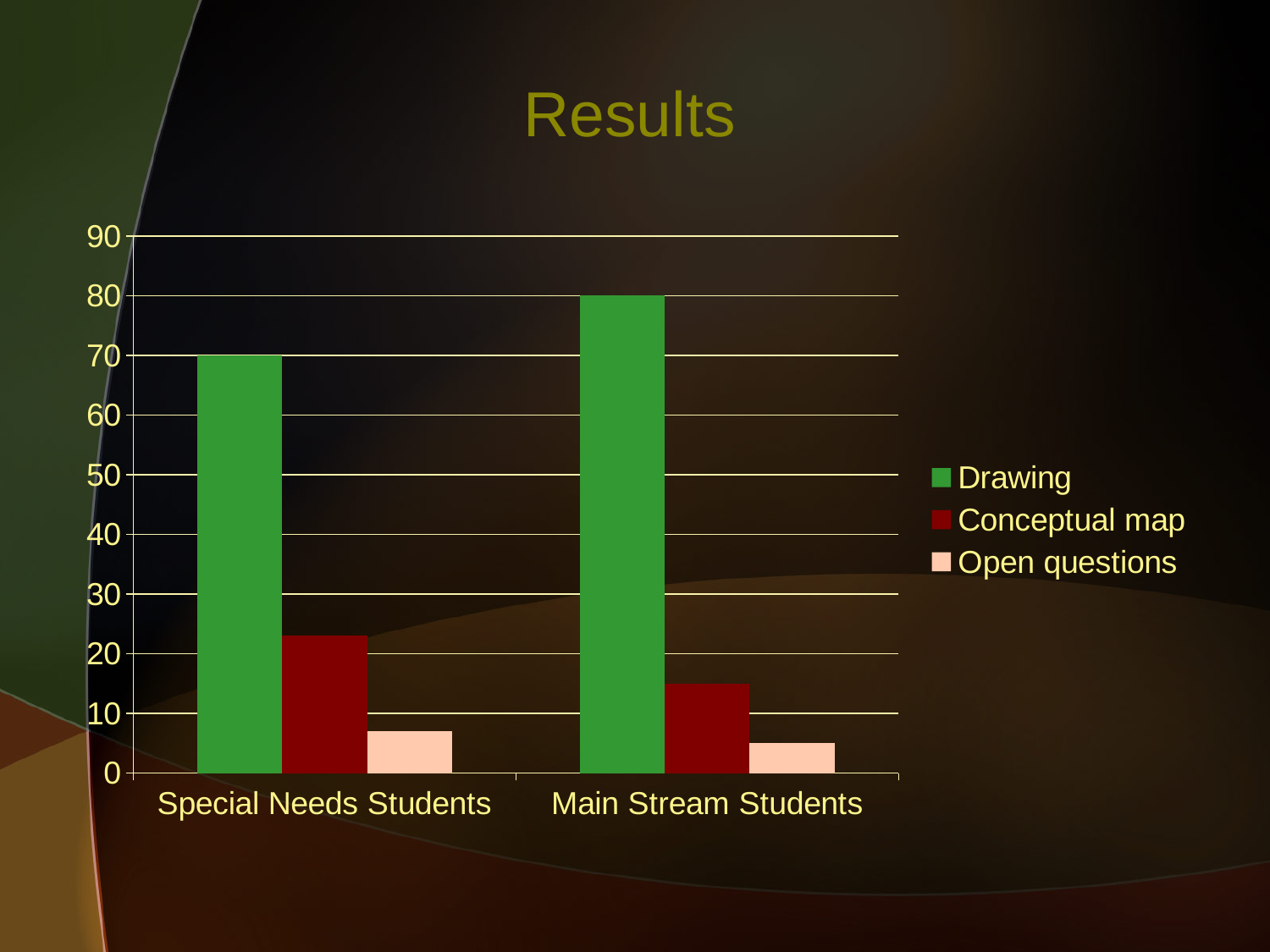
What is the difference between the Drawing values for Main Stream Students and Special Needs Students? 10 What is the Drawing value for Special Needs Students? 70 Is the Open questions value for Special Needs Students greater or less than 10? less How many categories are shown on the x axis? 2 Is the Conceptual map value for Special Needs Students greater or less than 20? greater Which series has the lowest value for Main Stream Students? Open questions What kind of chart is shown on the slide? bar chart What is the Drawing value for Main Stream Students? 80 What is the title of the slide containing the chart? Results How many series does the legend list? 3 Which category has the higher Drawing value? Main Stream Students Is the Conceptual map value for Main Stream Students greater or less than 20? less